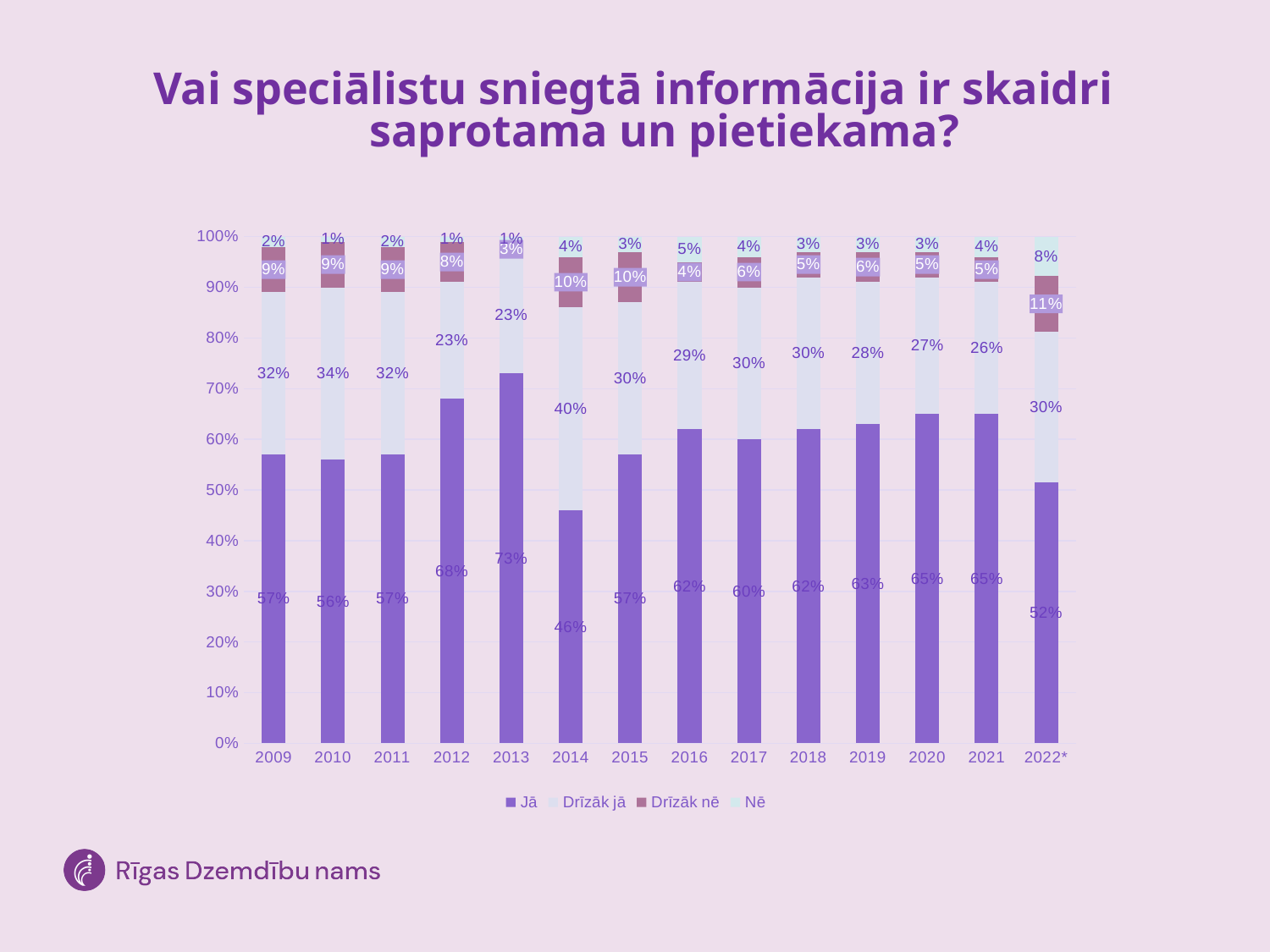
Which series is shown in the darkest purple colour? Jā What kind of chart is shown on the slide? Stacked bar chart What percentage answered "Jā" in 2013? 73% How many series does the legend list? 4 What is the difference between the "Jā" values for 2013 and 2014? 27 percentage points How many years are shown on the x axis? 14 What is the "Nē" value for 2022*? 8% In which year is the "Jā" share the lowest? 2014 What is the "Drīzāk jā" value for 2014? 40% Which year has the larger "Jā" value, 2012 or 2022*? 2012 What is the "Drīzāk nē" value for 2022*? 11% In which year is the "Jā" share the highest? 2013